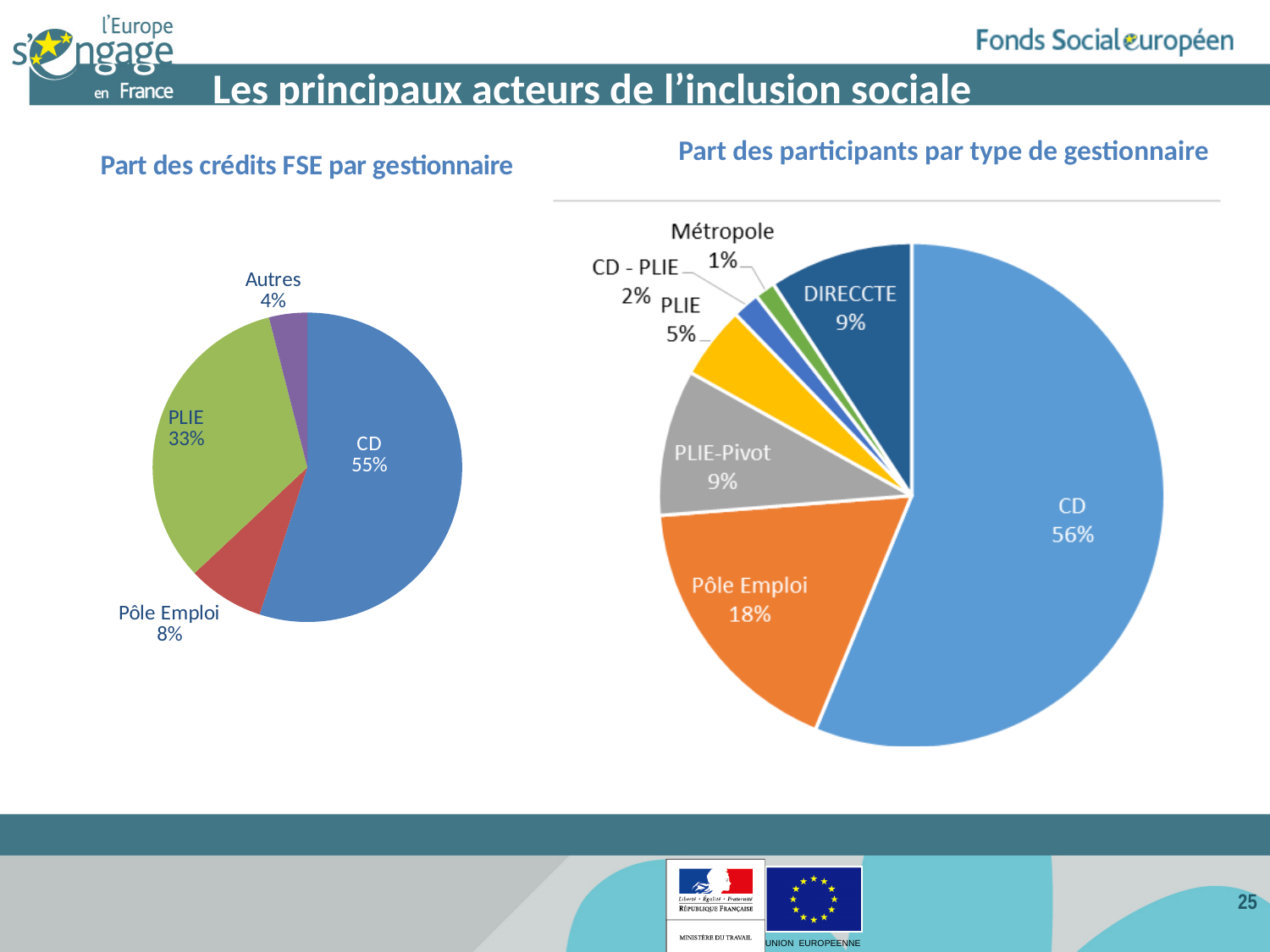
In the chart 'Part des crédits FSE par gestionnaire', how many slices does the pie have? 4 What type of chart is 'Part des participants par type de gestionnaire'? Pie chart In the chart 'Part des participants par type de gestionnaire', which category has the largest share? CD In the chart 'Part des crédits FSE par gestionnaire', which category has the smallest share? Autres In the chart 'Part des crédits FSE par gestionnaire', what share does CD have? 55% In the chart 'Part des crédits FSE par gestionnaire', what is the difference between the shares of CD and PLIE? 22 percentage points In the chart 'Part des participants par type de gestionnaire', what share does Métropole have? 1% In the chart 'Part des participants par type de gestionnaire', which is larger, the share of PLIE or the share of CD - PLIE? PLIE In the chart 'Part des crédits FSE par gestionnaire', what colour is the PLIE slice? Green In the chart 'Part des participants par type de gestionnaire', what share does Pôle Emploi have? 18% In the chart 'Part des crédits FSE par gestionnaire', what share does PLIE have? 33% In the chart 'Part des participants par type de gestionnaire', how many categories are shown? 7